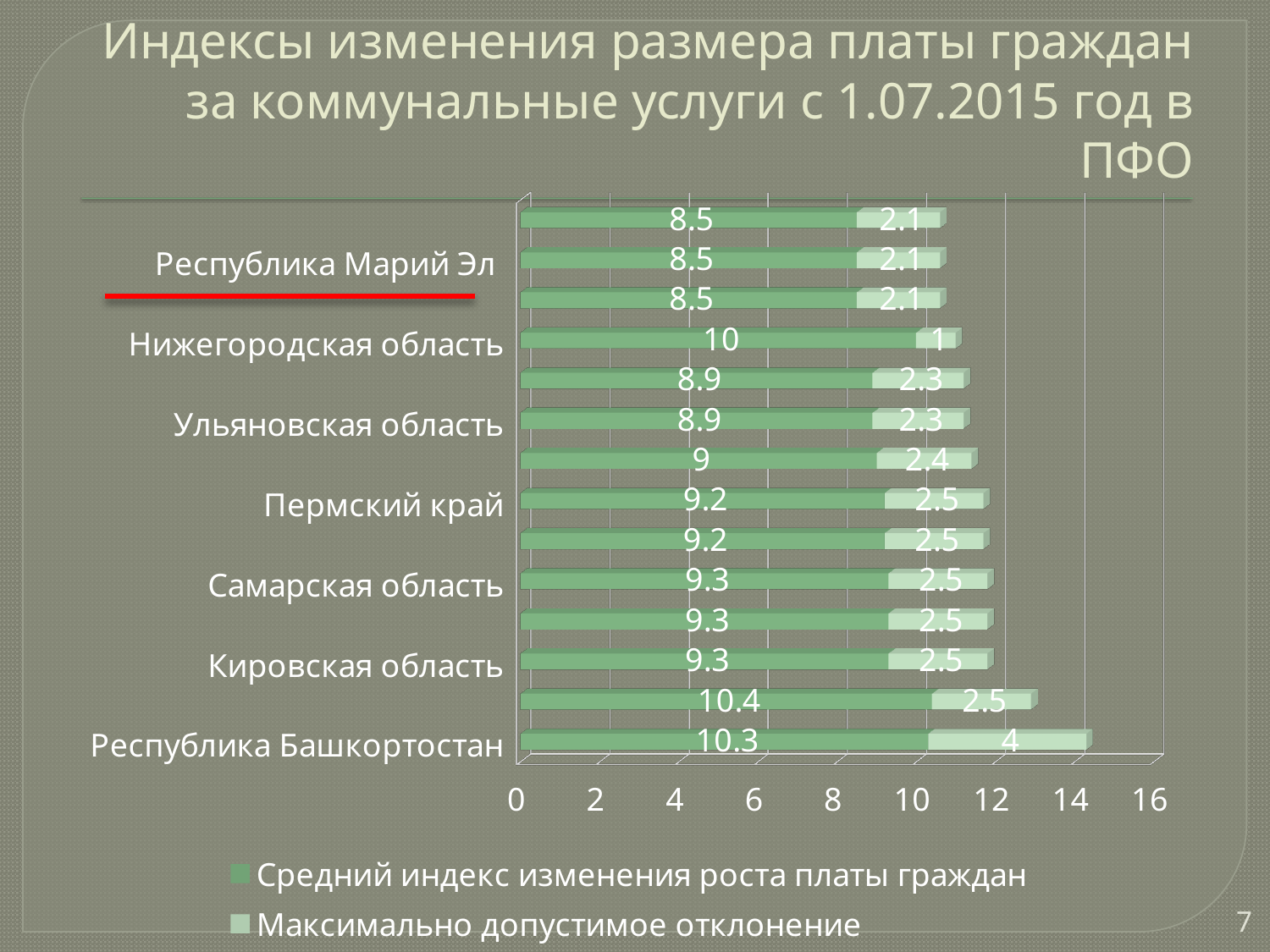
What is the difference between the 'Средний индекс изменения роста платы граждан' values for Республика Башкортостан and Республика Марий Эл? 1.8 Is the total of the stacked bar for Республика Марий Эл greater or less than 12? less What is the value of 'Максимально допустимое отклонение' for Ульяновская область? 2.3 What is the value of 'Средний индекс изменения роста платы граждан' for Республика Марий Эл? 8.5 Which category has the lowest value of 'Максимально допустимое отклонение'? Нижегородская область What kind of chart is shown on the slide? Bar chart What is the value of 'Максимально допустимое отклонение' for Нижегородская область? 1 Which has a larger 'Средний индекс изменения роста платы граждан': Нижегородская область or Ульяновская область? Нижегородская область What is the total of the stacked bar for Республика Башкортостан? 14.3 Which category has the highest value of 'Максимально допустимое отклонение'? Республика Башкортостан How many series does the legend list? 2 What is the value of 'Средний индекс изменения роста платы граждан' for Республика Башкортостан? 10.3